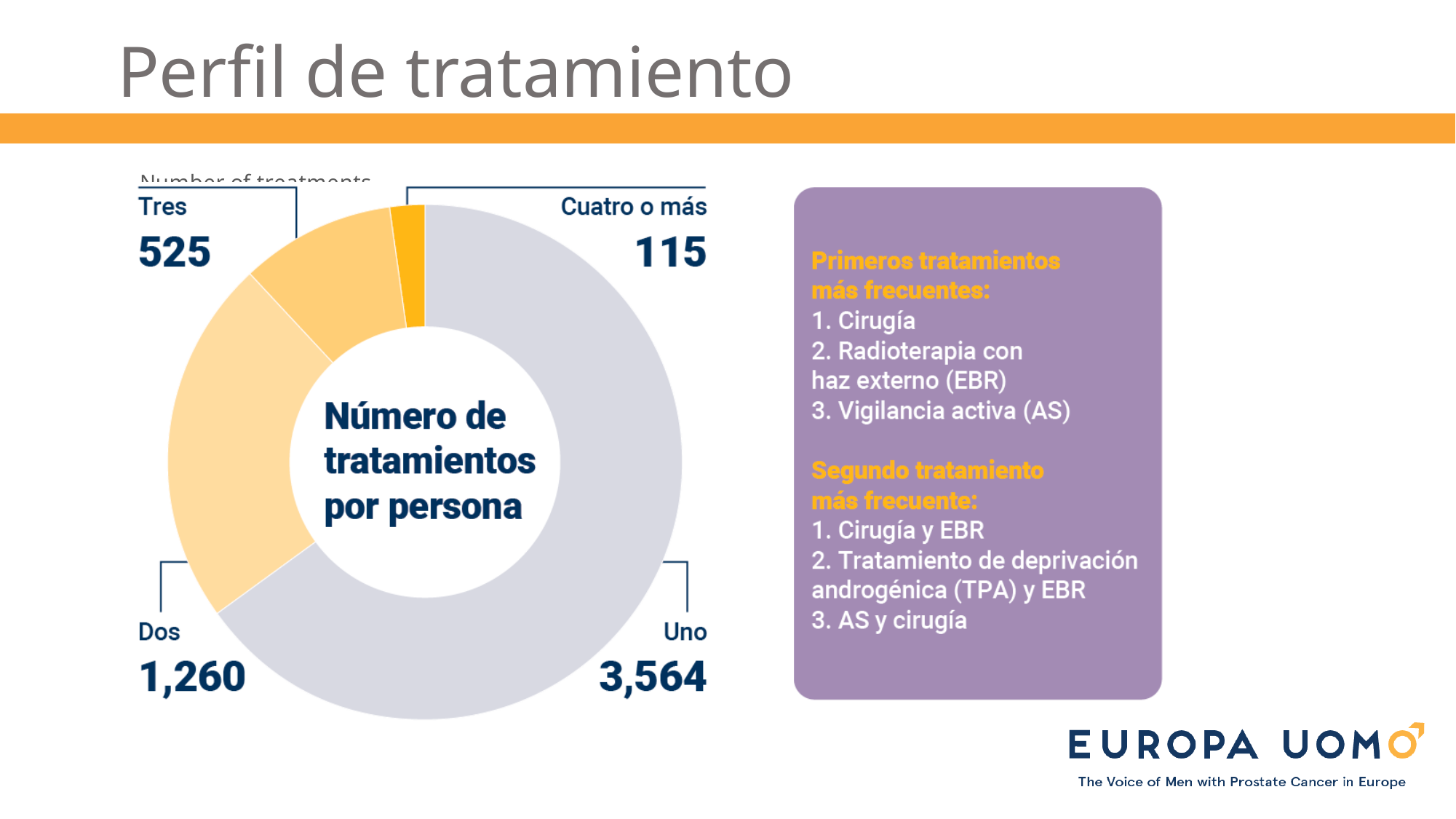
What is the value for "Cuatro o más" in the donut chart? 115 What is the difference between the values for "Dos" and "Tres"? 735 What is the value for "Uno" in the donut chart? 3,564 Which category has the smallest value in the donut chart? Cuatro o más What is the value for "Tres" in the donut chart? 525 What is the difference between the values for "Uno" and "Dos"? 2,304 How many categories are shown in the donut chart? 4 What text is written in the centre of the donut chart? Número de tratamientos por persona Which category has the largest value in the donut chart? Uno What is the value for "Dos" in the donut chart? 1,260 Which is larger, the value for "Tres" or the value for "Cuatro o más"? Tres What kind of chart is shown on the slide? Donut (pie) chart